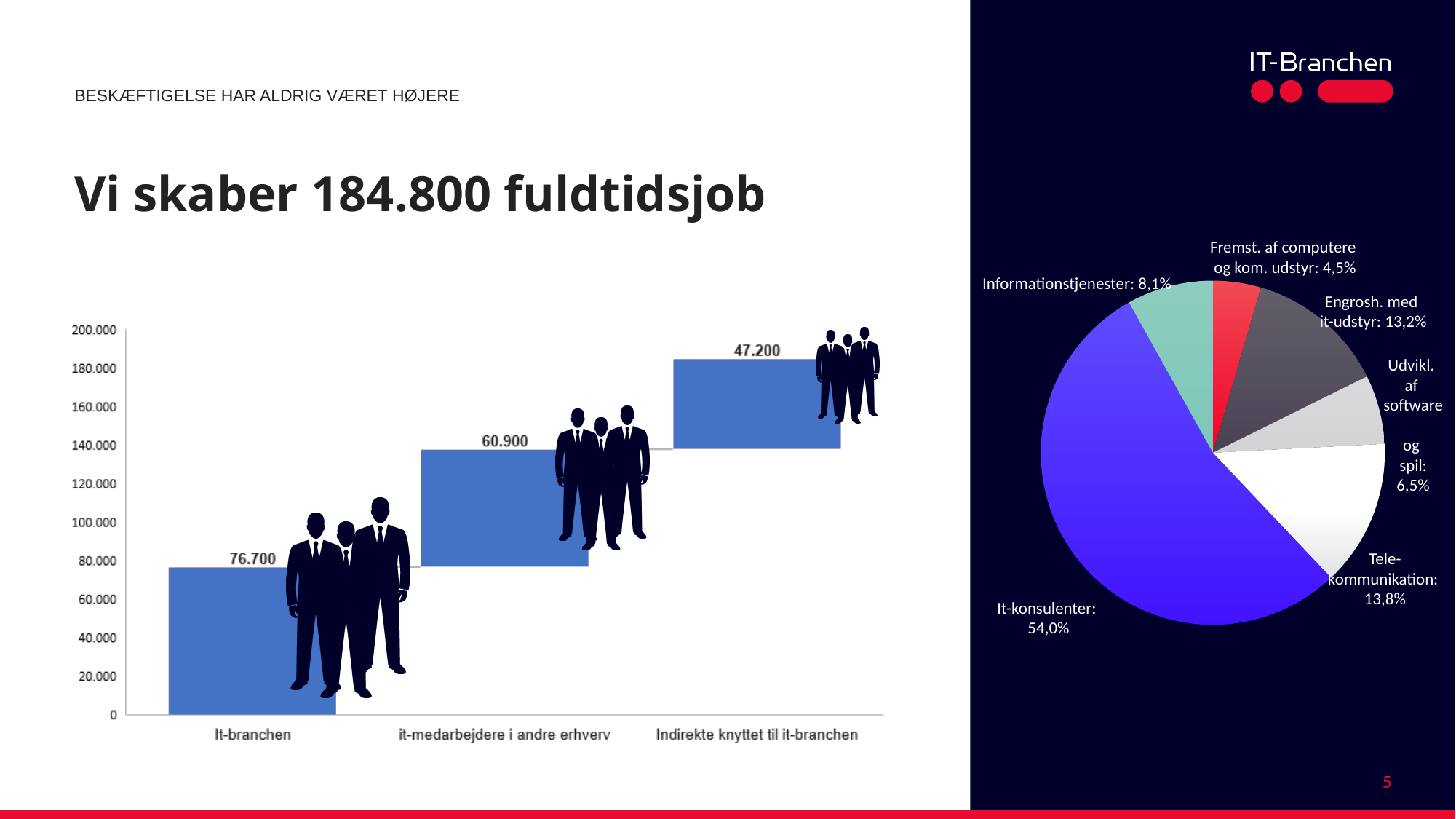
In the left chart, what is the value for It-branchen? 76.700 In the left chart, what is the value for Indirekte knyttet til it-branchen? 47.200 In the pie chart on the right, which is larger: Telekommunikation or Engrosh. med it-udstyr? Telekommunikation In the left chart, what is the difference between the values for It-branchen and it-medarbejdere i andre erhverv? 15.800 What kind of chart is the chart on the right side of the slide? pie chart In the pie chart on the right, what share does It-konsulenter have? 54,0% In the pie chart on the right, which slice is the smallest? Fremst. af computere og kom. udstyr In the left chart, which category has the highest value? It-branchen In the left chart, which category has the lowest value? Indirekte knyttet til it-branchen In the left chart, what is the value for it-medarbejdere i andre erhverv? 60.900 In the left chart, how many categories are shown on the x axis? 3 In the left chart, do the values rise or fall from left to right along the x axis? fall